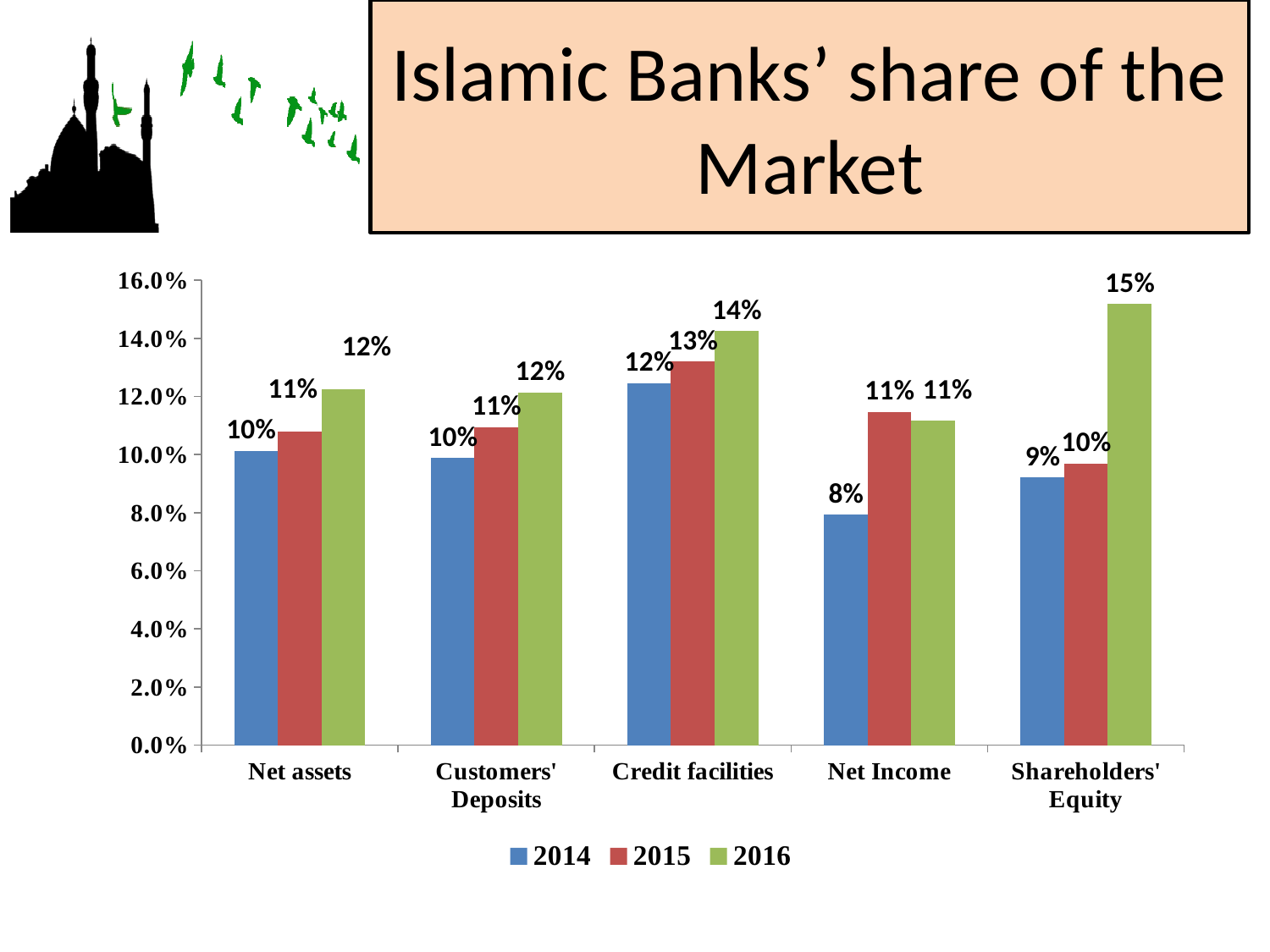
Do the values for Net assets rise or fall from 2014 to 2016? rise How many series does the legend list? 3 What is the value for Shareholders' Equity in 2016? 15% What is the Islamic banks' share of Credit facilities in 2016? 14% What is the difference between the 2016 and 2014 values for Shareholders' Equity? 6% Is the 2014 value for Net Income greater or less than 10.0%? less Which category has the lowest value for 2014? Net Income What is the value for Net Income in 2014? 8% Which category has the highest value for 2016? Shareholders' Equity Which is larger: the 2015 value for Credit facilities or the 2015 value for Net assets? Credit facilities How many categories are shown on the x axis? 5 What type of chart is shown on the slide? Bar chart